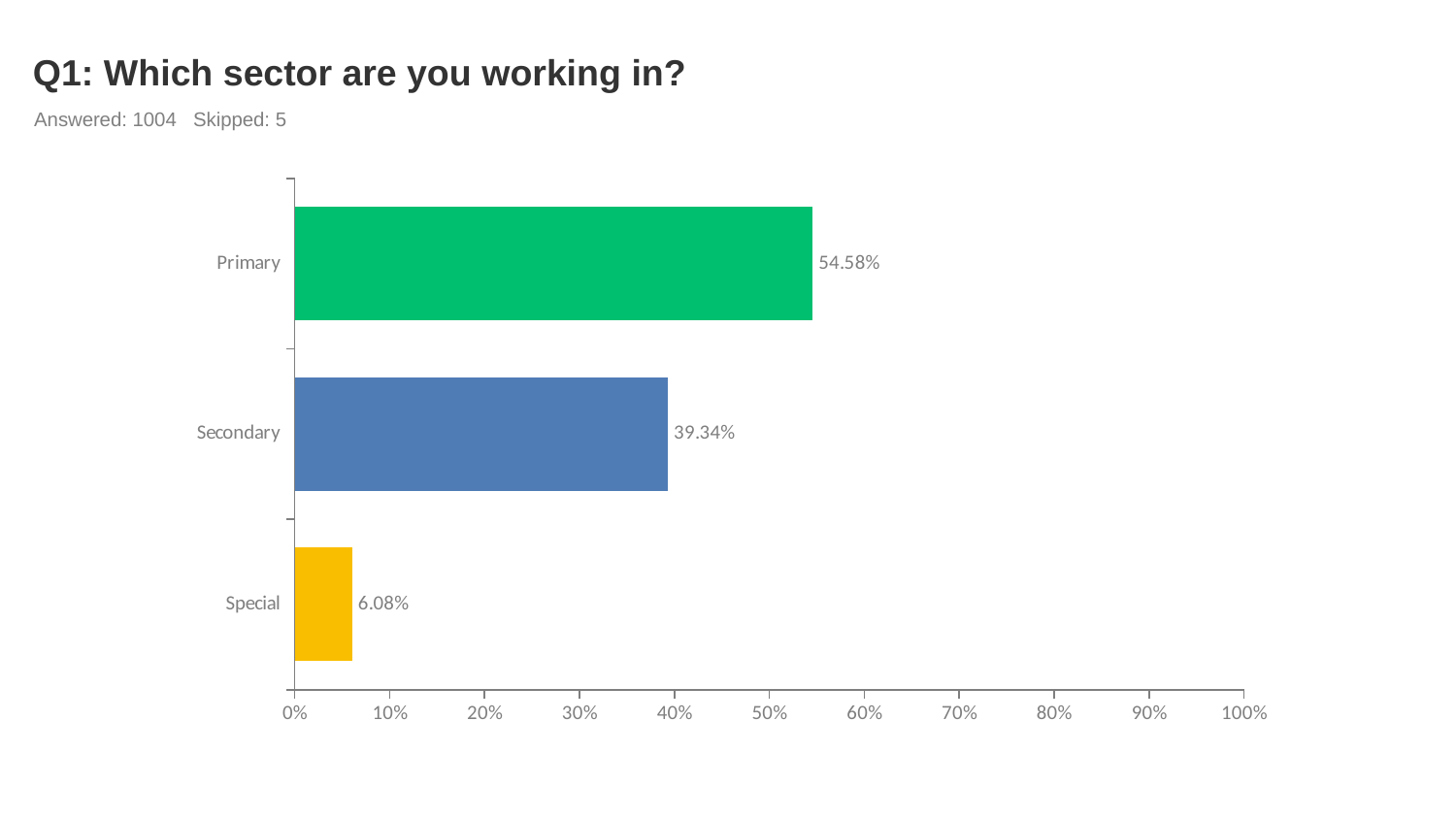
What is the difference between the values for Primary and Secondary? 15.24% What is the value for Primary? 54.58% What is the value for Special? 6.08% What is the title of the chart? Q1: Which sector are you working in? What is the difference between the values for Secondary and Special? 33.26% How many sectors are shown in the chart? 3 Which sector has the highest value? Primary What is the value for Secondary? 39.34% What kind of chart is shown on the slide? bar chart Which sector has the lowest value? Special Which is larger, the value for Secondary or the value for Special? Secondary Is the value for Primary greater or less than 50%? greater